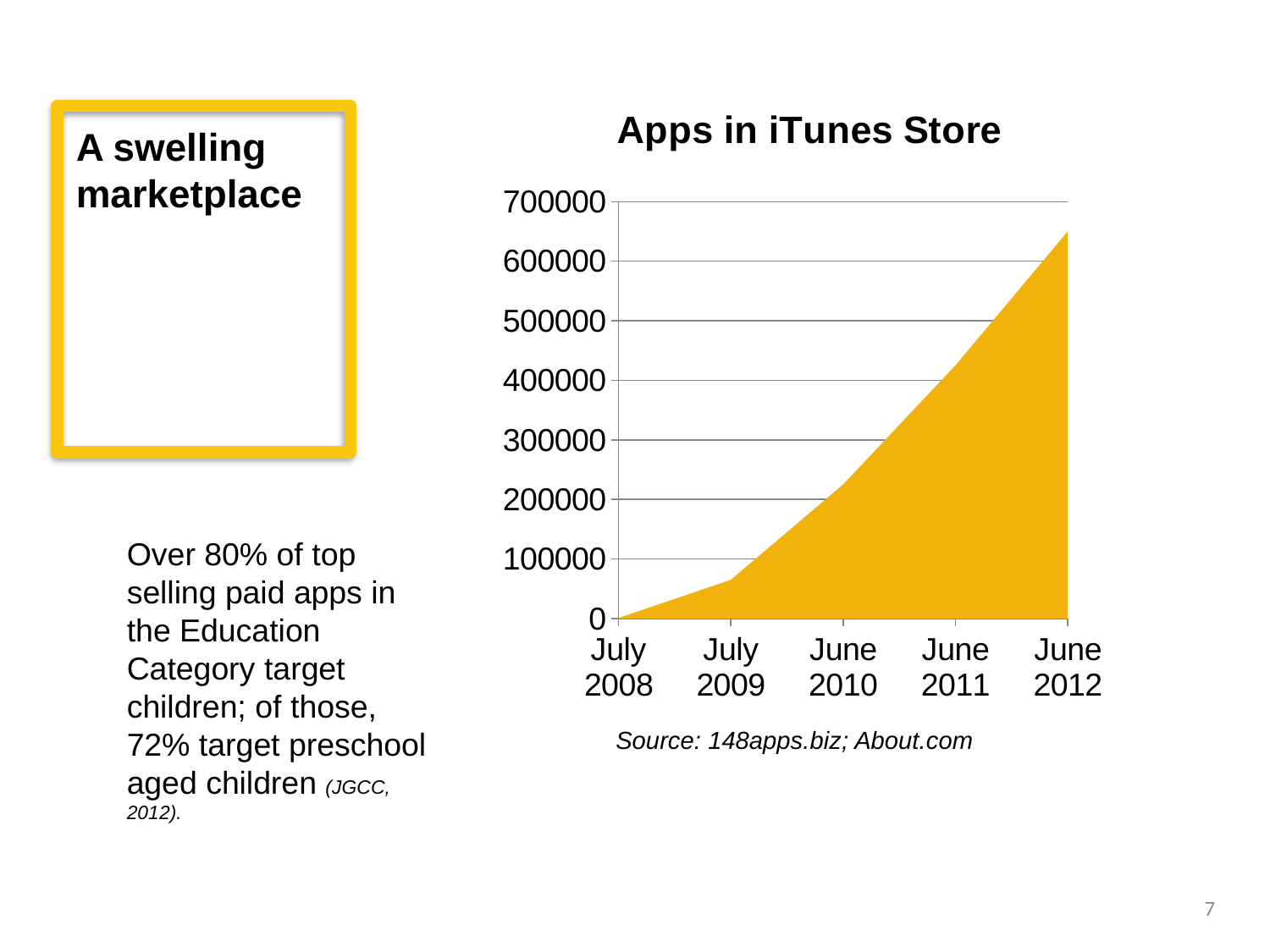
Is the value for June 2011 greater or less than 400000? greater Is the value for June 2012 greater or less than 600000? greater Is the value for June 2010 greater or less than 300000? less Which time point has the lowest number of apps in the iTunes Store? July 2008 What is the title of the chart? Apps in iTunes Store Which time point has the highest number of apps in the iTunes Store? June 2012 How many time points are shown on the x axis of the chart? 5 Which is larger, the value for June 2010 or the value for June 2011? June 2011 Do the values in the chart rise or fall from July 2008 to June 2012? rise What kind of chart is shown on the slide? area chart What source is cited below the chart? 148apps.biz; About.com